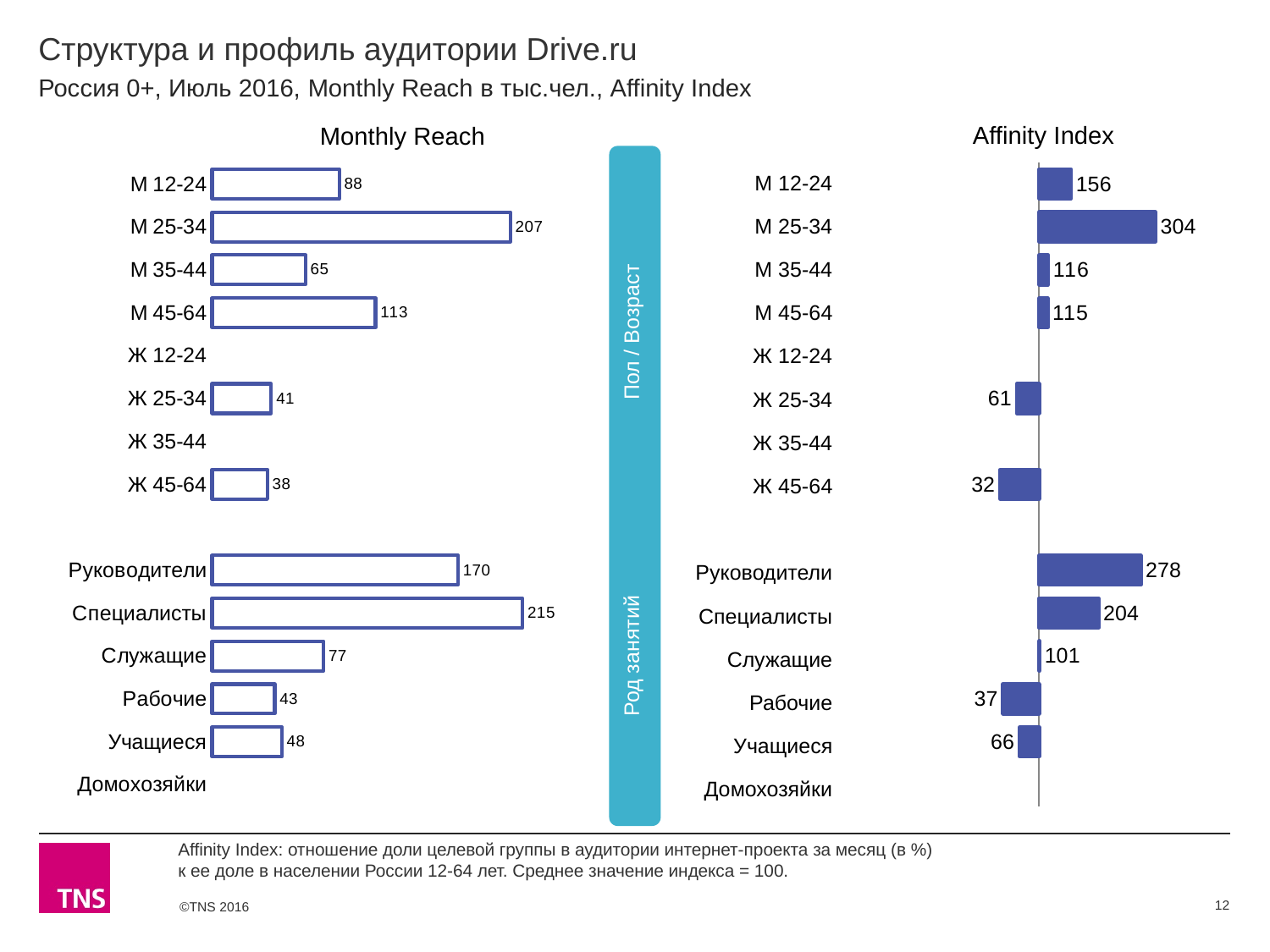
On the Affinity Index chart, which category has the lowest value? Ж 45-64 On the Affinity Index chart, what is the value for Ж 25-34? 61 What kind of chart is the Affinity Index chart? Bar chart On the Affinity Index chart, what is the value for Руководители? 278 On the Monthly Reach chart, what is the value for Учащиеся? 48 On the Monthly Reach chart, what is the value for М 25-34? 207 On the Affinity Index chart, which category has the highest value? М 25-34 On the Affinity Index chart, what is the difference between М 25-34 and М 12-24? 148 On the Monthly Reach chart, which is larger: М 45-64 or М 35-44? М 45-64 On the Monthly Reach chart, what is the difference between Руководители and Служащие? 93 On the Affinity Index chart, which is larger: Учащиеся or Рабочие? Учащиеся On the Monthly Reach chart, which category has the highest value? Специалисты